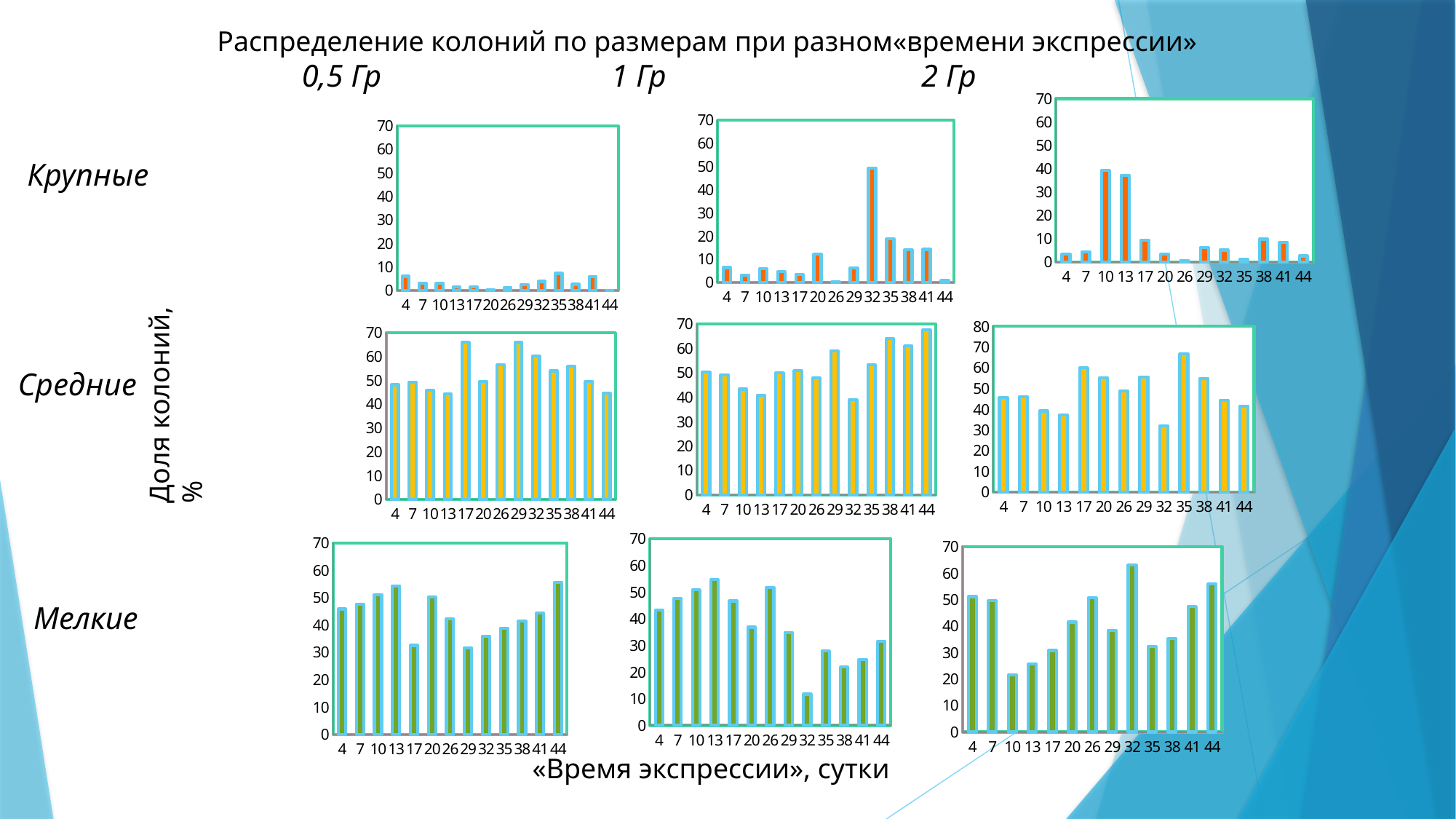
In the 'Мелкие' 1 Гр chart, is the value for 32 greater or less than 20? less In the 'Крупные' 1 Гр chart, how many categories are shown on the x axis? 13 In the 'Средние' 2 Гр chart, which x-axis category has the highest bar? 35 In the 'Крупные' 1 Гр chart, which x-axis category has the highest bar? 32 In the 'Крупные' 1 Гр chart, is the value for 32 greater or less than 40? greater In the 'Средние' 1 Гр chart, which is larger, the value for 29 or the value for 32? 29 In the 'Средние' 2 Гр chart, which x-axis category has the lowest bar? 32 In the 'Мелкие' 1 Гр chart, which x-axis category has the lowest bar? 32 How many charts are shown on the slide? 9 What kind of chart is used in the 'Крупные' row for 1 Гр? bar chart In the 'Мелкие' 2 Гр chart, which is larger, the value for 32 or the value for 10? 32 In the 'Крупные' 2 Гр chart, is the value for 10 greater or less than 30? greater